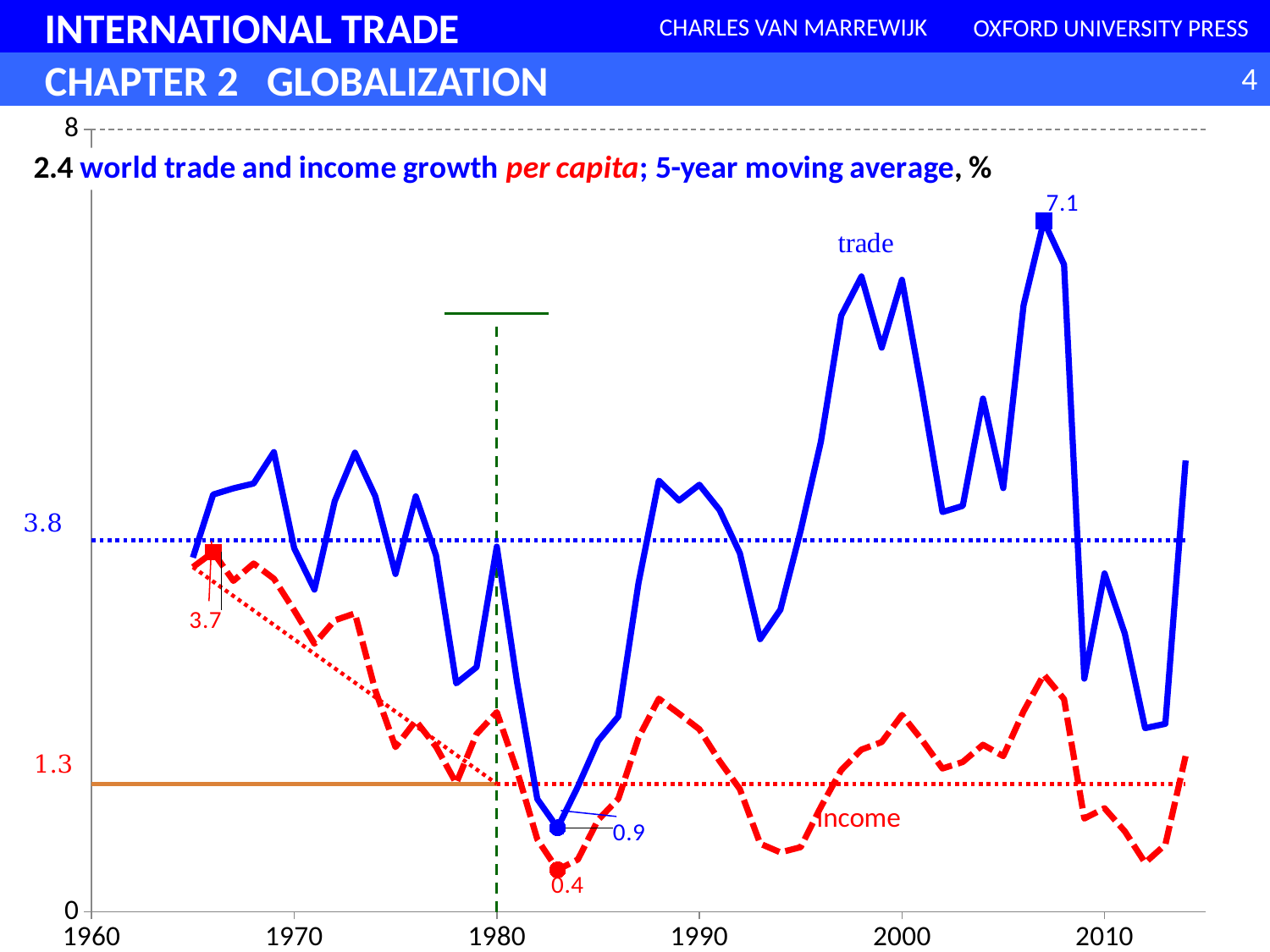
What is the labelled lowest value of the trade series? 0.9 How many data series are plotted on the chart? 2 What is the labelled peak value of the trade series? 7.1 What is the difference between the labelled peak (7.1) and the labelled low (0.9) of the trade series? 6.2 Which series reaches the highest value on the chart? trade At their labelled low points in the early 1980s, which series has the larger value, trade (0.9) or income (0.4)? trade What value is marked by the blue dotted horizontal line? 3.8 Is the income value around 1994 greater or less than 1.3? less Is the trade value around 2000 greater or less than 3.8? greater What kind of chart is shown on the slide? line chart What is the labelled lowest value of the income series? 0.4 What is the labelled value of the income series at its marked starting point in the mid-1960s? 3.7